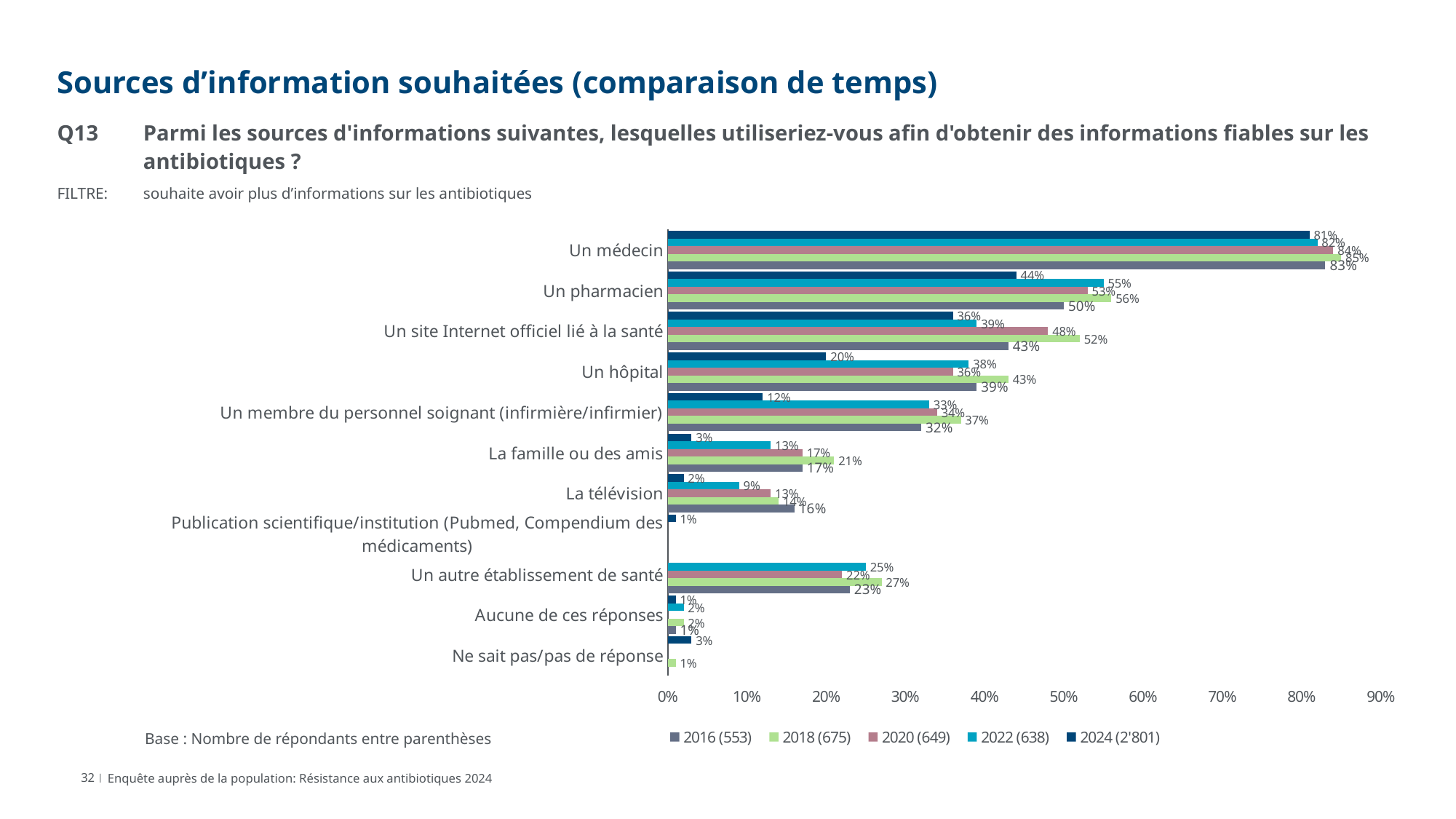
What is the value for 'Un hôpital' in the 2024 (2'801) series? 20% What is the difference between the 2018 (675) and 2024 (2'801) values for 'Un membre du personnel soignant (infirmière/infirmier)'? 25 percentage points What is the value for 'Un pharmacien' in the 2018 (675) series? 56% Which category has the highest value in the 2024 (2'801) series? Un médecin What is the difference between the 2022 (638) and 2024 (2'801) values for 'Un pharmacien'? 11 percentage points What kind of chart is shown on the slide? bar chart How many series does the legend list? 5 What is the value for 'Un autre établissement de santé' in the 2022 (638) series? 25% What is the highest value shown on the x axis? 90% Which is larger for 'La télévision': the 2016 (553) value or the 2022 (638) value? 2016 (553) What is the value for 'Un site Internet officiel lié à la santé' in the 2020 (649) series? 48% What is the value for 'Un médecin' in the 2024 (2'801) series? 81%